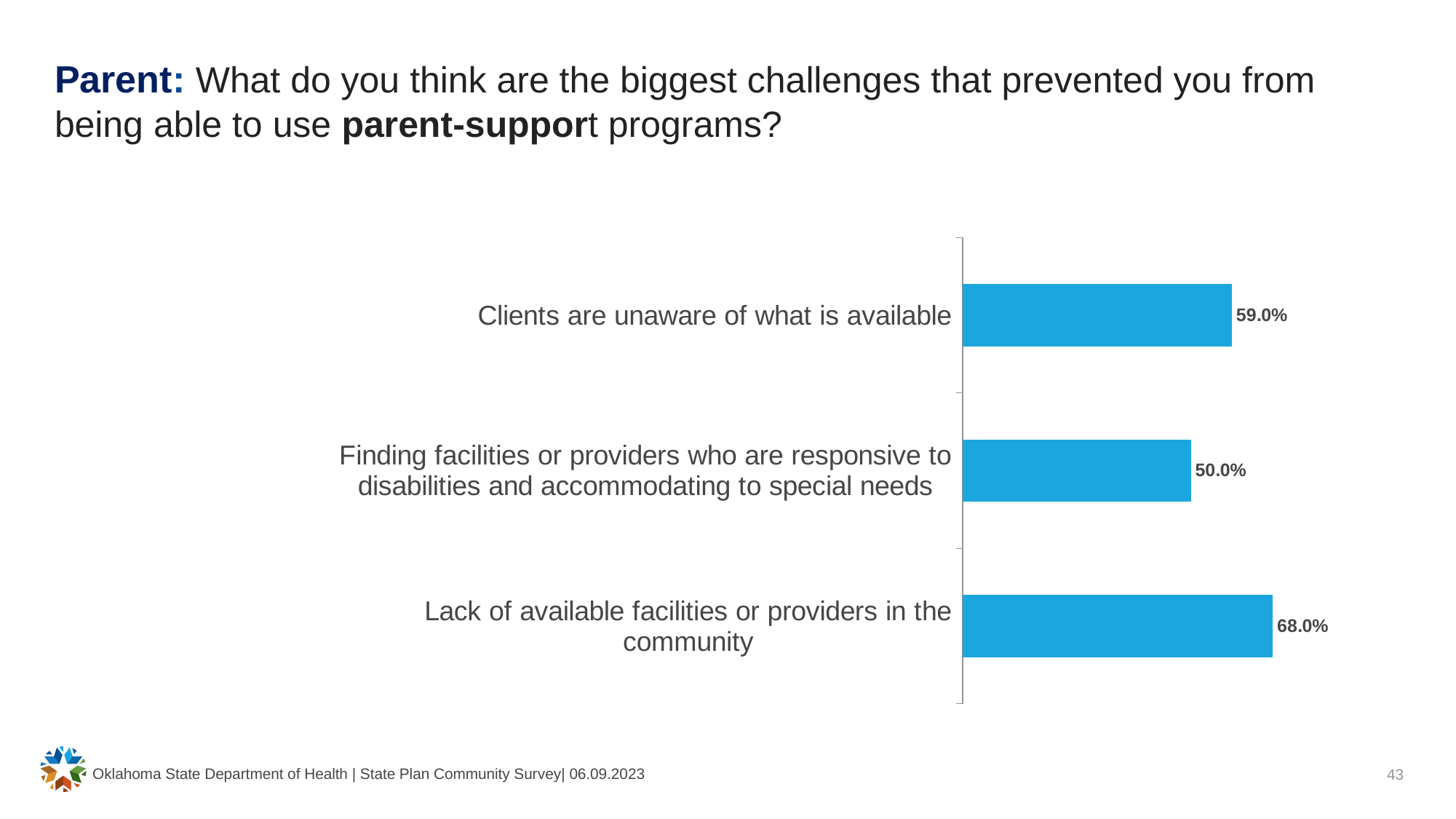
Which category has the lowest value? Finding facilities or providers who are responsive to disabilities and accommodating to special needs What is the value for "Finding facilities or providers who are responsive to disabilities and accommodating to special needs"? 50.0% What kind of chart is shown on the slide? Bar chart What is the value for "Lack of available facilities or providers in the community"? 68.0% What is the difference between the values for "Clients are unaware of what is available" and "Finding facilities or providers who are responsive to disabilities and accommodating to special needs"? 9.0% How many categories are shown in the chart? 3 Which is larger: the value for "Clients are unaware of what is available" or the value for "Finding facilities or providers who are responsive to disabilities and accommodating to special needs"? Clients are unaware of what is available Which category has the highest value? Lack of available facilities or providers in the community Are the bars in the chart horizontal or vertical? Horizontal What is the difference between the values for "Lack of available facilities or providers in the community" and "Clients are unaware of what is available"? 9.0% What is the value for "Clients are unaware of what is available"? 59.0% What colour are the bars in the chart? Blue